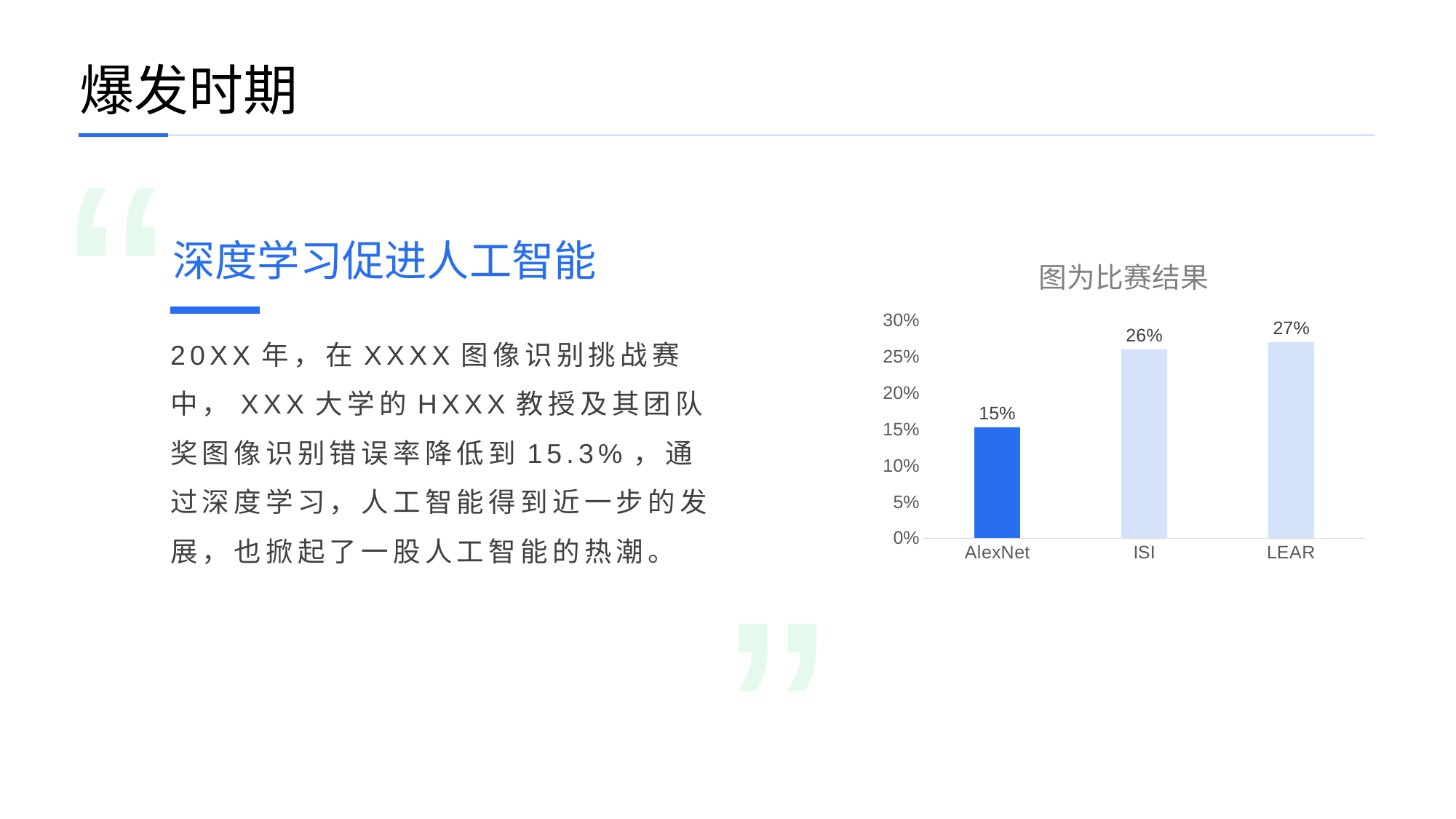
Which category has the lowest value? AlexNet What is the value for LEAR? 27% Which is larger, the value for ISI or the value for AlexNet? ISI What is the title of the chart? 图为比赛结果 What is the difference between the values for LEAR and AlexNet? 12% Is the value for AlexNet greater or less than 20%? less What is the value for ISI? 26% How many categories are shown on the x axis? 3 What is the difference between the values for ISI and AlexNet? 11% What is the value for AlexNet? 15% Which category has the highest value? LEAR What kind of chart is shown on the slide? bar chart